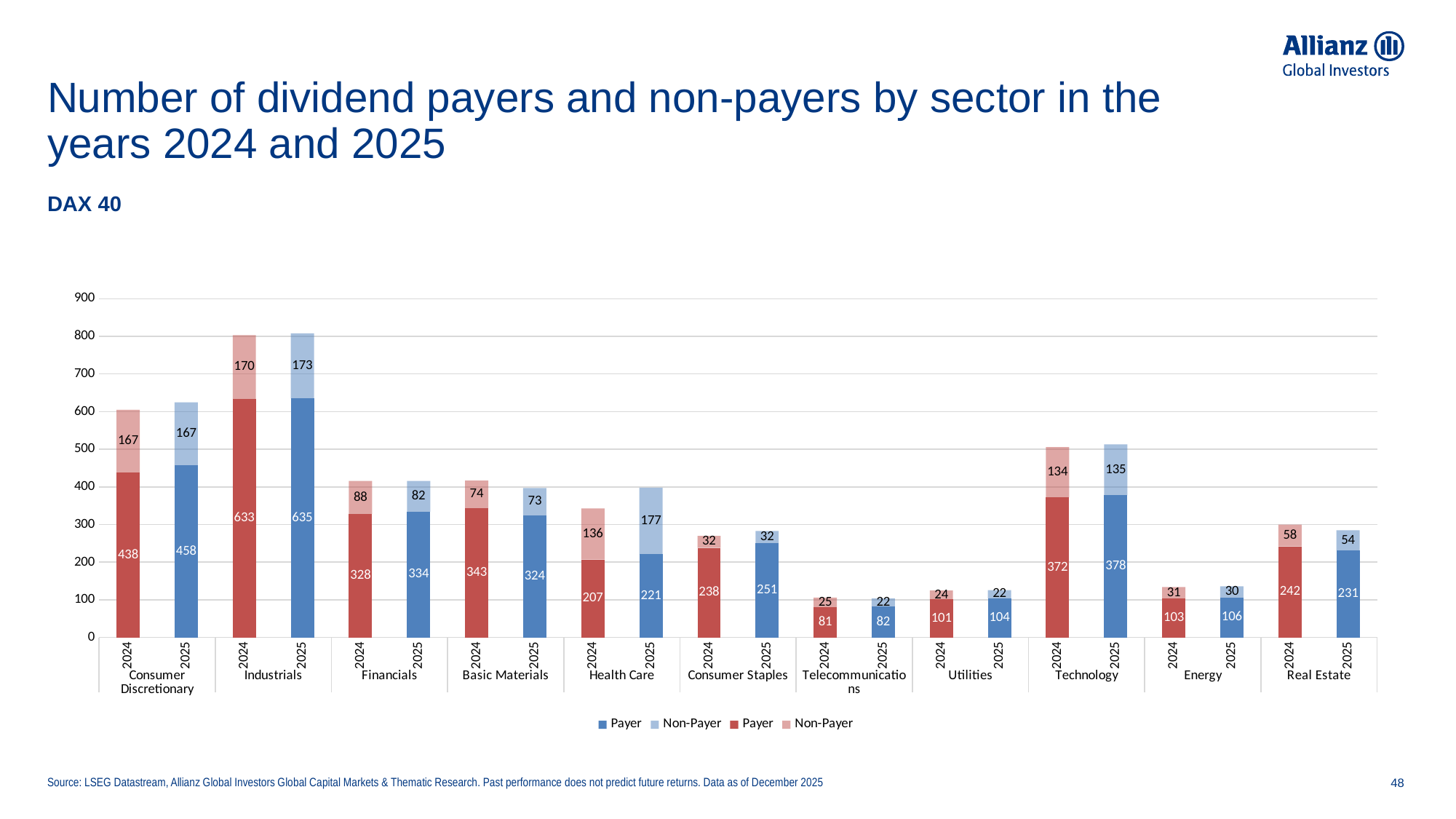
What is the difference between the number of payers in Industrials and in Consumer Discretionary in 2024? 195 What is the number of payers in the Technology sector in 2024? 372 What is the total height of the Industrials 2025 stacked bar (payers plus non-payers)? 808 What is the total of the Consumer Discretionary 2024 stacked bar? 605 By how much did the number of non-payers in Health Care increase from 2024 to 2025? 41 Which is larger: the number of payers in Basic Materials in 2024 or in 2025? 2024 Which sector has the lowest number of dividend payers in 2024? Telecommunications How many non-payers are shown for Health Care in 2024? 136 How many sectors are shown on the x axis of the chart? 11 What kind of chart is shown on the slide? Stacked bar chart What is the number of dividend payers in the Industrials sector in 2025? 635 Which sector has the highest number of dividend payers in 2025? Industrials